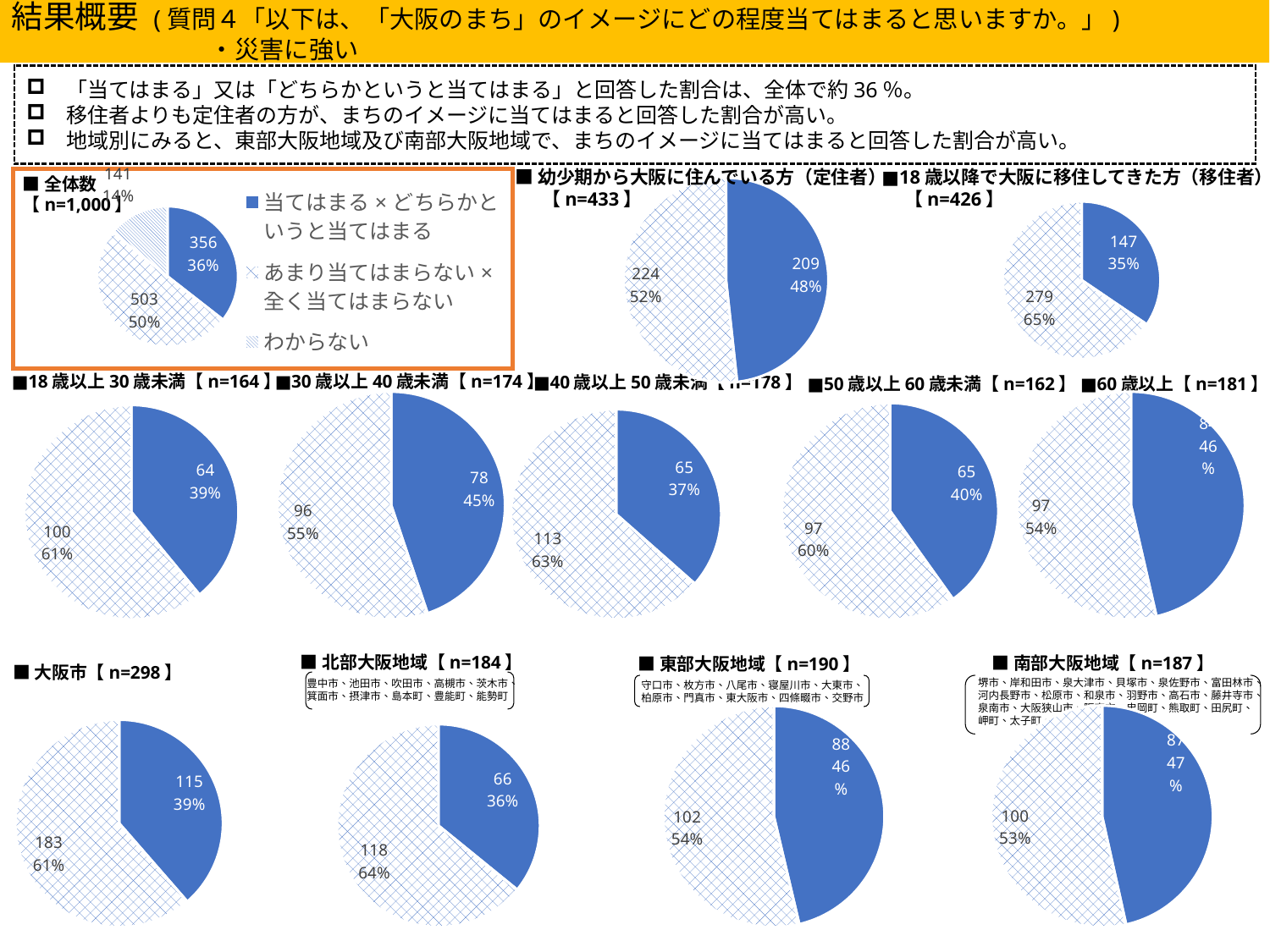
「18歳以上30歳未満【n=164】」と「50歳以上60歳未満【n=162】」の円グラフで、当てはまると回答した割合が高いのはどちらですか。 50歳以上60歳未満 「全体数【n=1,000】」の円グラフで、「あまり当てはまらない×全く当てはまらない」の回答数はいくつですか。 503 「40歳以上50歳未満【n=178】」の円グラフで、当てはまらないと回答した割合は何%ですか。 63% 「大阪市【n=298】」の円グラフは、どの種類のグラフですか。 円グラフ 「幼少期から大阪に住んでいる方（定住者）」と「18歳以降で大阪に移住してきた方（移住者）」の円グラフで、当てはまると回答した割合の差は何ポイントですか。 13ポイント 「東部大阪地域【n=190】」の円グラフで、当てはまると回答した人数は何人ですか。 88 「全体数【n=1,000】」の円グラフで、「当てはまる×どちらかというと当てはまる」の割合は何%ですか。 36% 「18歳以降で大阪に移住してきた方（移住者）【n=426】」の円グラフで、当てはまらないと回答した人数は何人ですか。 279 「全体数【n=1,000】」の円グラフで、最も割合が小さい項目はどれですか。 わからない 「全体数【n=1,000】」の円グラフの凡例には、いくつの項目がありますか。 3 「30歳以上40歳未満【n=174】」の円グラフで、当てはまると回答した人数は何人ですか。 78 「幼少期から大阪に住んでいる方（定住者）【n=433】」の円グラフで、当てはまると回答した割合は何%ですか。 48%